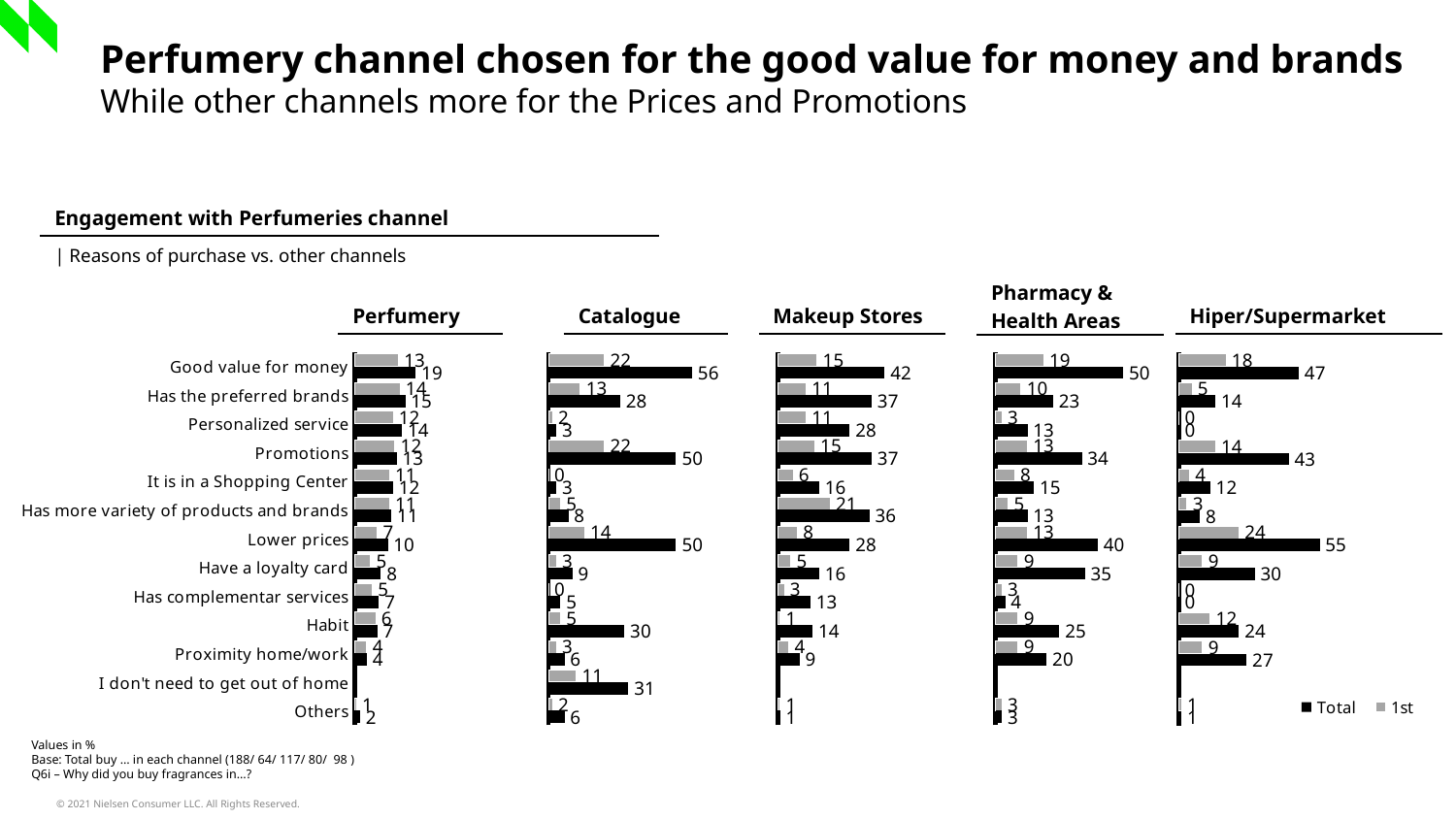
In the Perfumery chart, which reason has the highest Total value? Good value for money What type of chart is used for the Perfumery data? Bar chart In the Makeup Stores chart, what is the Total value for Has more variety of products and brands? 36 In the Hiper/Supermarket chart, which reason has the highest Total value? Lower prices In the Catalogue chart, what is the difference between the Total values for Good value for money and Has the preferred brands? 28 Which colour represents the Total series in the legend? Black In the Hiper/Supermarket chart, what is the Total value for Lower prices? 55 In the Pharmacy & Health Areas chart, which is larger: the Total value for Lower prices or the Total value for Promotions? Lower prices In the Makeup Stores chart, which is larger: the Total value for Good value for money or the Total value for Promotions? Good value for money How many series does the legend list? 2 In the Pharmacy & Health Areas chart, what is the 1st value for Good value for money? 19 In the Catalogue chart, what is the Total value for Good value for money? 56